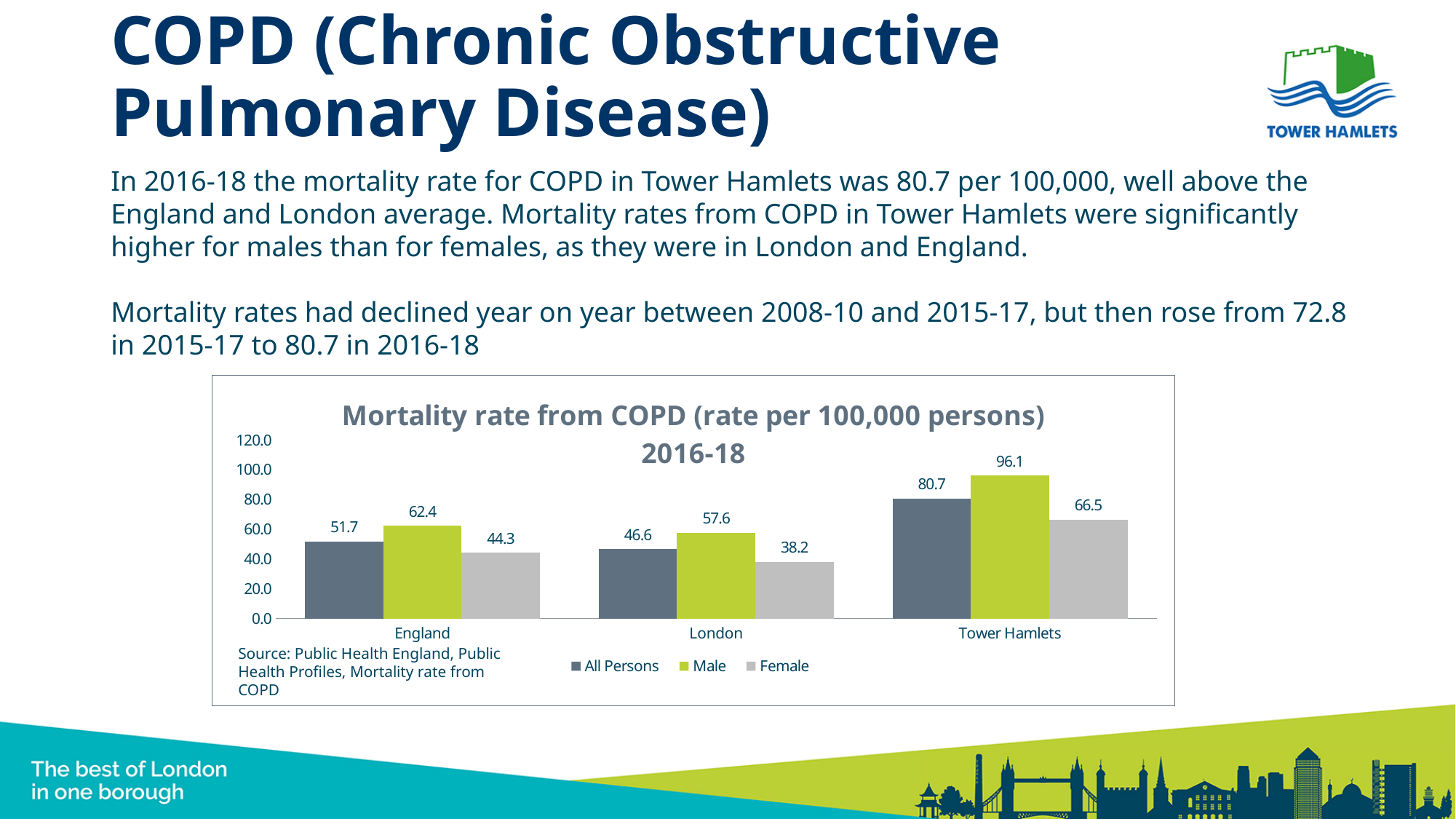
What type of chart is shown on the slide? Bar chart Which is larger: the male COPD mortality rate in England or in London? England What is the difference between the male and female COPD mortality rates in Tower Hamlets? 29.6 How many series does the chart legend list? 3 How many areas are shown on the x axis of the chart? 3 Is the all persons COPD mortality rate for Tower Hamlets greater or less than 60.0? greater What colour are the Male bars in the chart? Green Which area has the lowest COPD mortality rate for females? London What is the COPD mortality rate for females in London? 38.2 Which area has the highest COPD mortality rate for all persons? Tower Hamlets What is the COPD mortality rate for males in Tower Hamlets? 96.1 What is the COPD mortality rate for all persons in England? 51.7